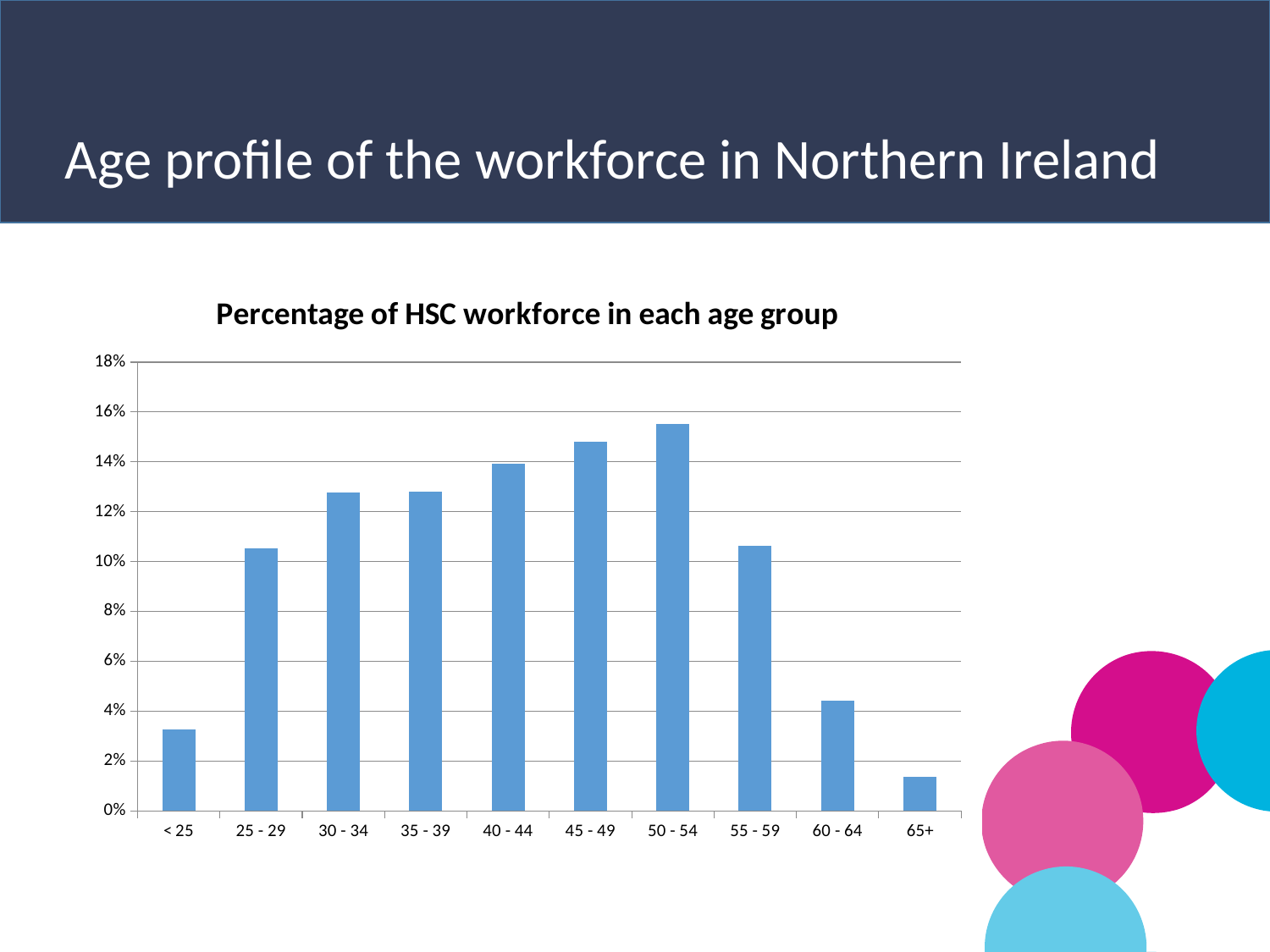
What is the highest value shown on the vertical axis of the chart? 18% Is the value for the 60 - 64 age group greater or less than 6%? less Which age group has the lowest percentage of the HSC workforce? 65+ What type of chart is shown on the slide? Bar chart Which age group has a larger share of the workforce, 45 - 49 or 55 - 59? 45 - 49 Is the value for the 40 - 44 age group greater or less than 12%? greater What is the title of the chart? Percentage of HSC workforce in each age group Is the value for the < 25 age group greater or less than 4%? less Which age group has the highest percentage of the HSC workforce? 50 - 54 How many age groups are shown on the x axis of the chart? 10 Which age group has a larger share of the workforce, < 25 or 60 - 64? 60 - 64